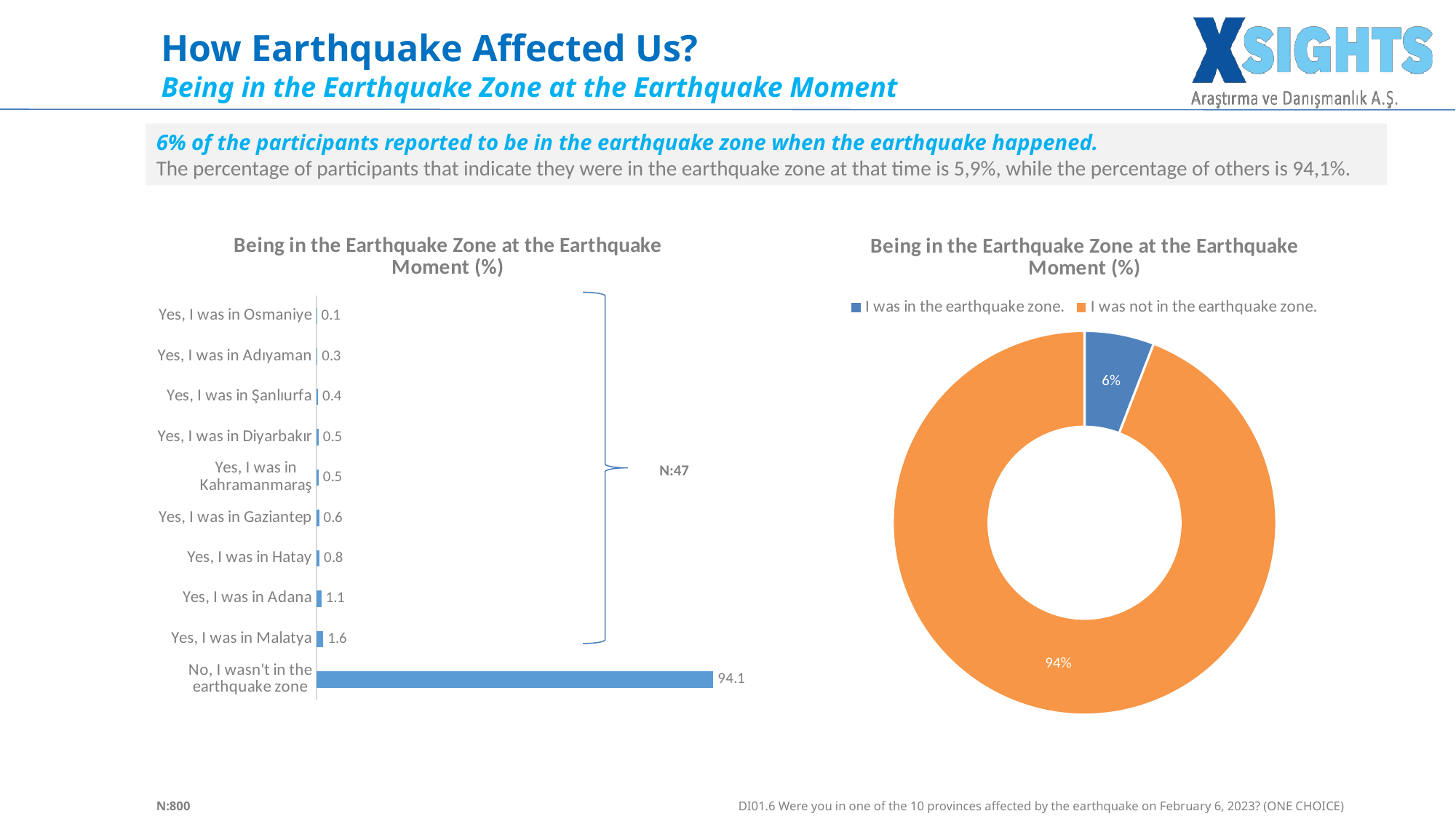
In the doughnut chart on the right, what colour is the "I was not in the earthquake zone." slice? Orange In the bar chart on the left, what is the difference between the values for "Yes, I was in Malatya" and "Yes, I was in Adana"? 0.5 What kind of chart is the chart on the left? Bar chart In the bar chart on the left, what is the value for "Yes, I was in Malatya"? 1.6 In the bar chart on the left, what is the value for "Yes, I was in Hatay"? 0.8 How many series does the legend of the doughnut chart on the right list? 2 In the bar chart on the left, which is larger: the value for "Yes, I was in Gaziantep" or "Yes, I was in Adıyaman"? Yes, I was in Gaziantep In the bar chart on the left, which category has the highest value? No, I wasn't in the earthquake zone In the bar chart on the left, what is the value for "No, I wasn't in the earthquake zone"? 94.1 In the bar chart on the left, which category has the lowest value? Yes, I was in Osmaniye How many categories does the bar chart on the left show? 10 In the doughnut chart on the right, what share is labelled for "I was in the earthquake zone."? 6%